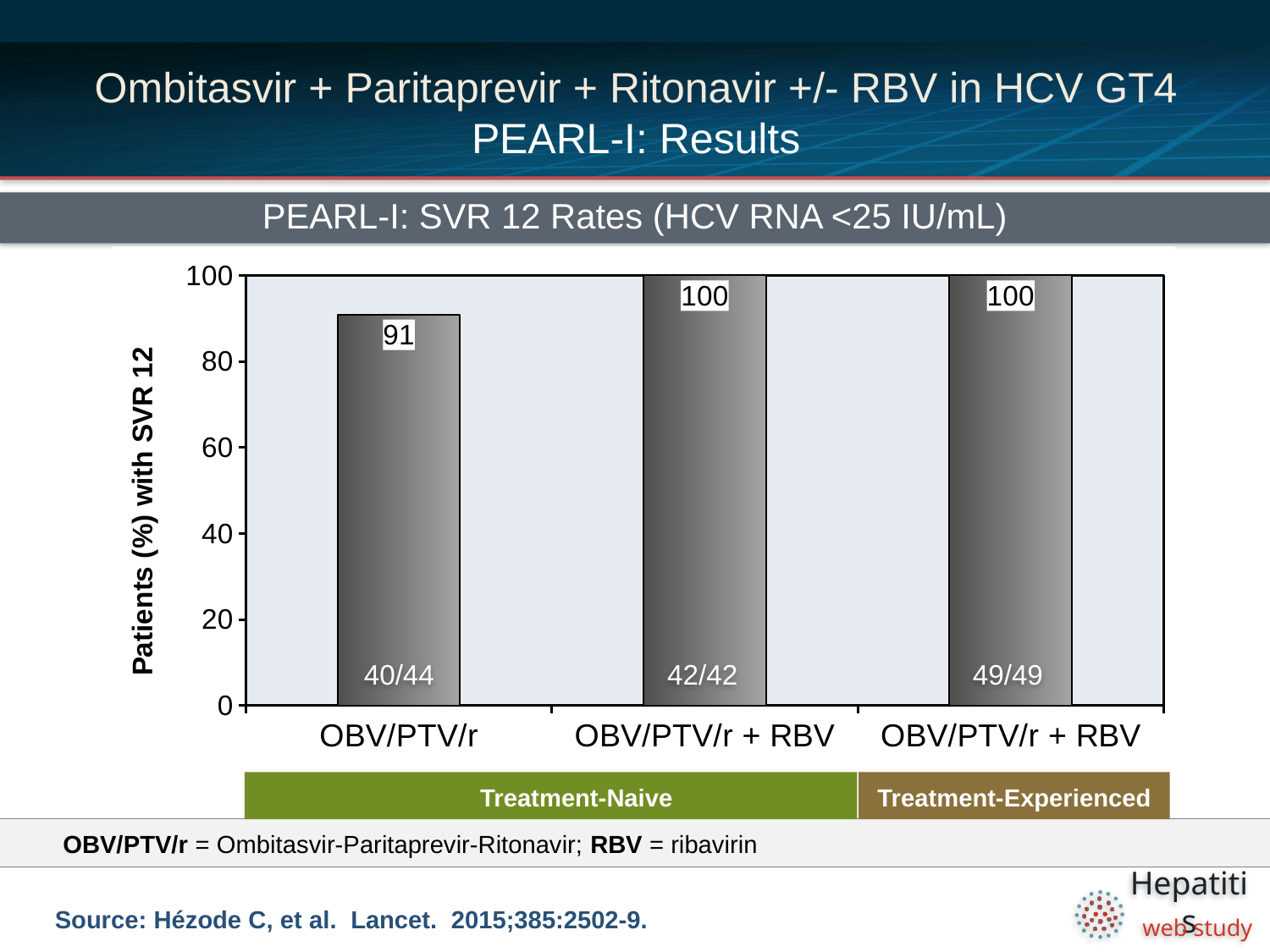
What is the SVR 12 rate for the treatment-experienced OBV/PTV/r + RBV group? 100 What is the SVR 12 rate for the treatment-naive OBV/PTV/r + RBV group? 100 Which group has the lowest SVR 12 rate? OBV/PTV/r (Treatment-Naive) Which has a higher SVR 12 rate: treatment-naive OBV/PTV/r or treatment-naive OBV/PTV/r + RBV? OBV/PTV/r + RBV What is the label of the y-axis? Patients (%) with SVR 12 How many bars are shown in the chart? 3 What is the SVR 12 rate for the treatment-naive OBV/PTV/r group? 91 Is the SVR 12 rate for the treatment-naive OBV/PTV/r group greater or less than 80? greater How many patients achieved SVR 12 out of the total in the treatment-naive OBV/PTV/r group? 40/44 What is the difference in SVR 12 rate between the treatment-naive OBV/PTV/r + RBV group and the treatment-naive OBV/PTV/r group? 9 How many patients achieved SVR 12 out of the total in the treatment-experienced OBV/PTV/r + RBV group? 49/49 What type of chart is shown on the slide? Bar chart